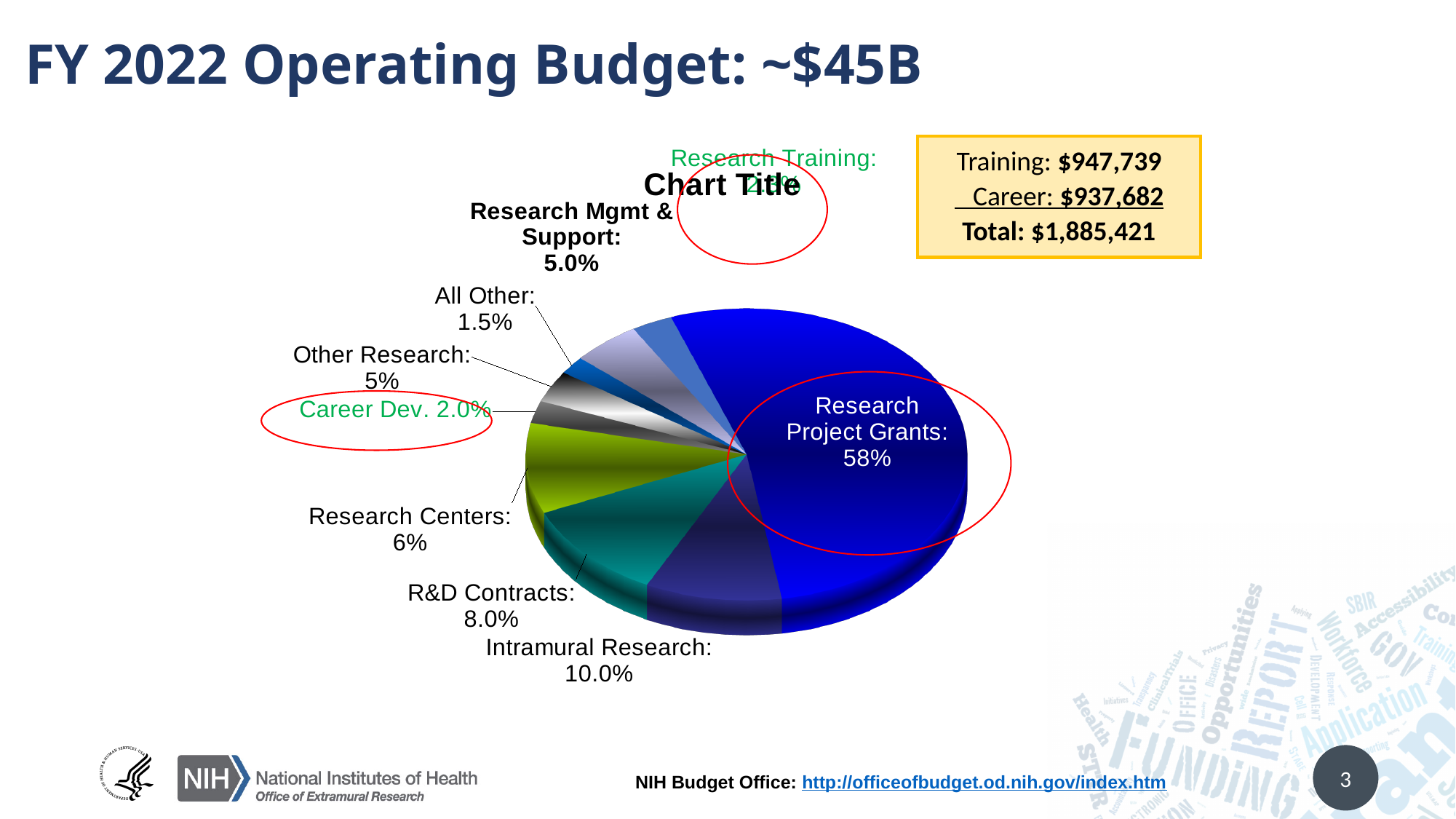
Which category has the largest slice of the pie? Research Project Grants What is the value shown for R&D Contracts? 8.0% What is the value shown for All Other? 1.5% What is the value shown for Research Centers? 6% What is the value shown for Career Dev.? 2.0% Which category has the smallest slice of the pie? All Other What is the value shown for Research Mgmt & Support? 5.0% What kind of chart is shown on the slide? pie chart Which is larger, Research Centers or Other Research? Research Centers What is the value shown for Intramural Research? 10.0% What is the difference in percentage points between Intramural Research and R&D Contracts? 2.0 What share of the pie does Research Project Grants represent? 58%